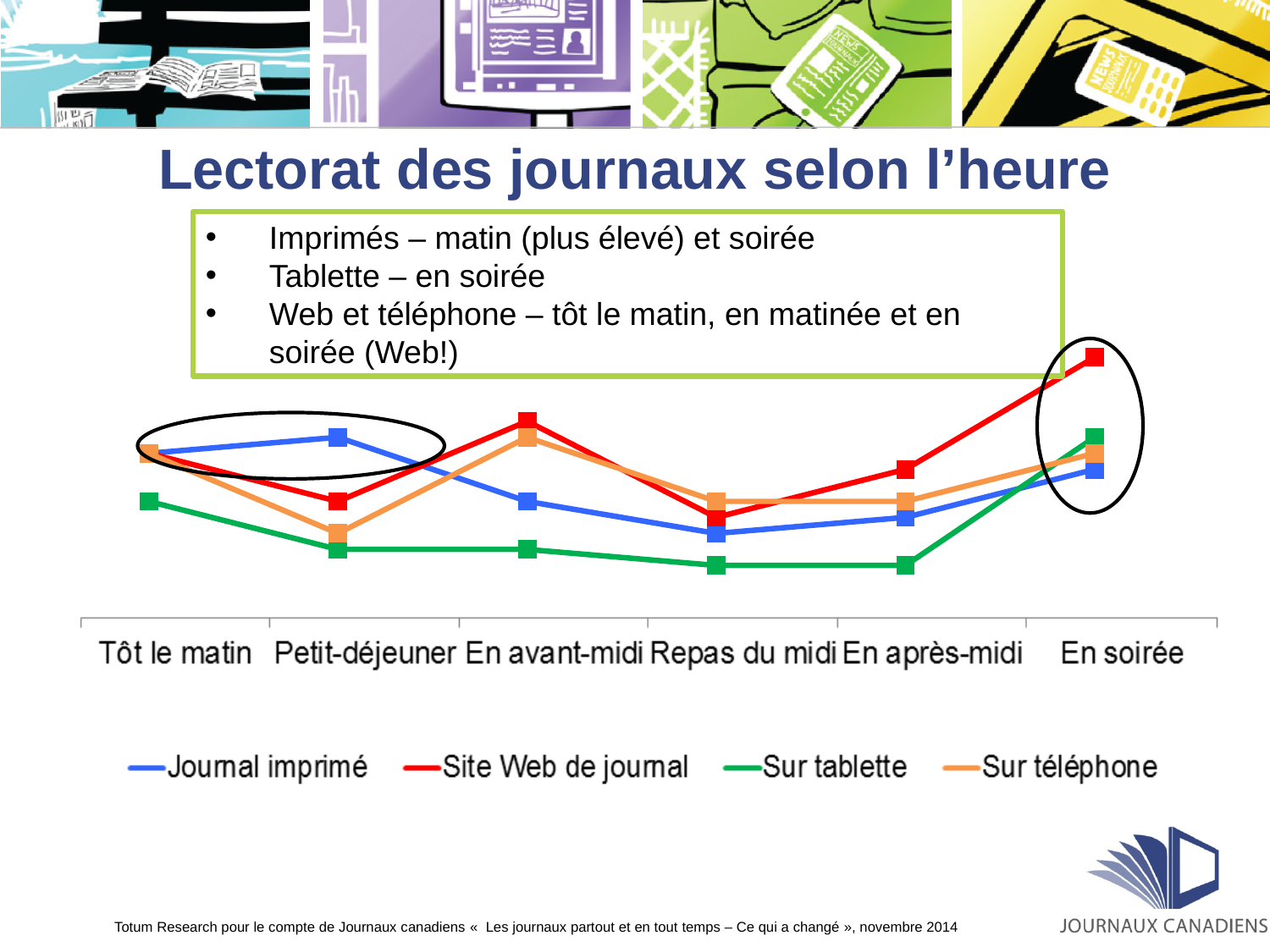
At which time of day does Sur téléphone reach its lowest value? Petit-déjeuner Which series has the highest value at En soirée? Site Web de journal Which series has the lowest value at Tôt le matin? Sur tablette What kind of chart is shown on the slide? Line chart How many time-of-day categories are shown on the x axis of the chart? 6 Does the Sur tablette line rise or fall from En après-midi to En soirée? Rise At which time of day does Site Web de journal reach its highest value? En soirée Which series has the lowest value at Repas du midi? Sur tablette At En après-midi, which is larger: Site Web de journal or Journal imprimé? Site Web de journal What colour is the Sur tablette line in the chart? Green Which series has the highest value at Petit-déjeuner? Journal imprimé How many series does the chart legend list? 4